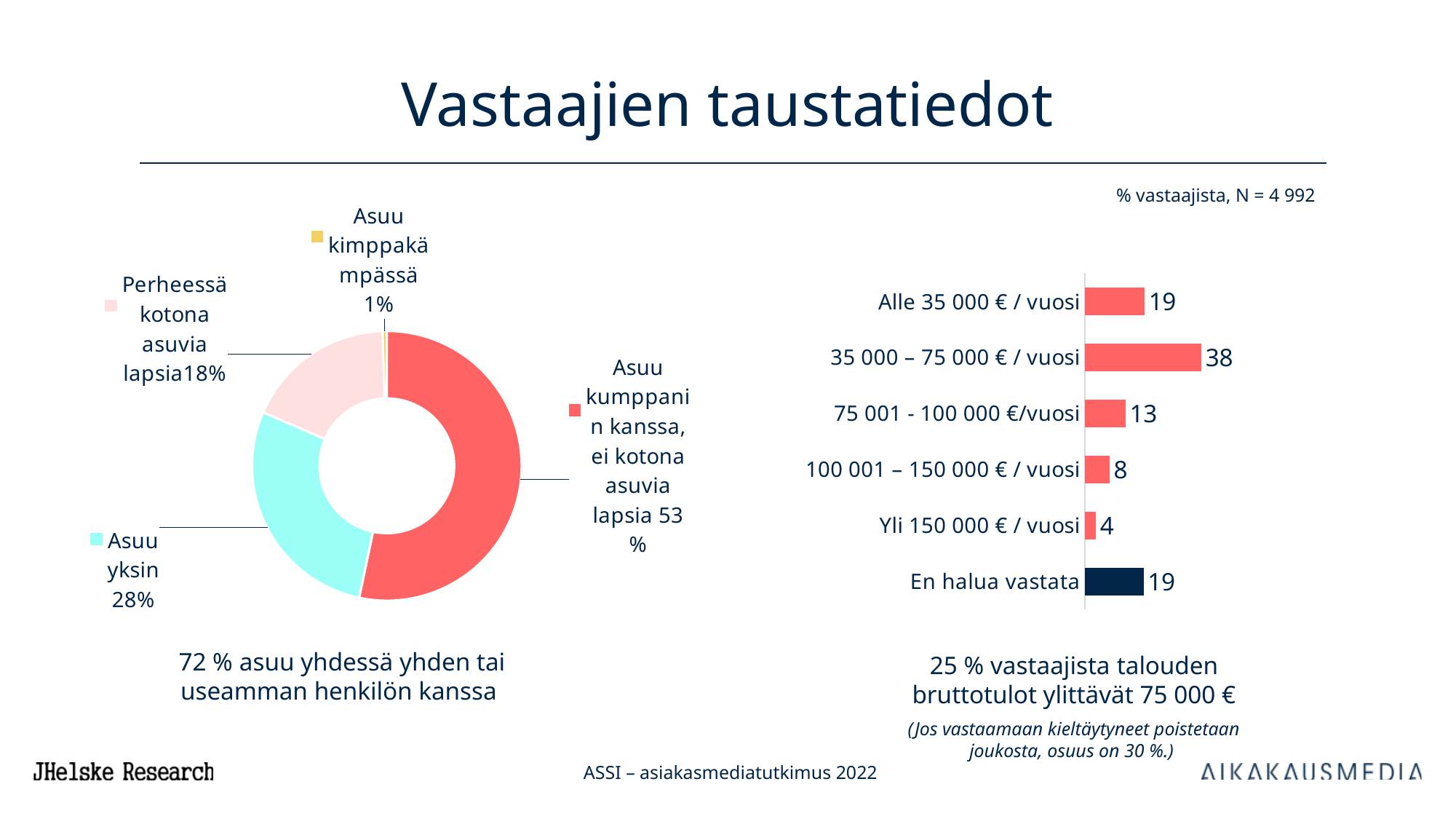
In the donut chart on the left, what share is labelled for "Asuu yksin"? 28% How many categories does the bar chart on the right show? 6 How many slices does the donut chart on the left have? 4 In the donut chart on the left, which category has the largest share? Asuu kumppanin kanssa, ei kotona asuvia lapsia In the donut chart on the left, what share is labelled for "Perheessä kotona asuvia lapsia"? 18% In the bar chart on the right, what is the difference between the values for "35 000 – 75 000 € / vuosi" and "75 001 - 100 000 €/vuosi"? 25 In the bar chart on the right, which category has the highest value? 35 000 – 75 000 € / vuosi In the bar chart on the right, which is larger: the value for "100 001 – 150 000 € / vuosi" or the value for "75 001 - 100 000 €/vuosi"? 75 001 - 100 000 €/vuosi In the bar chart on the right, what is the value for "Yli 150 000 € / vuosi"? 4 In the bar chart on the right, what is the value for "35 000 – 75 000 € / vuosi"? 38 What kind of chart is on the right side of the slide? Bar chart In the bar chart on the right, which category has the lowest value? Yli 150 000 € / vuosi